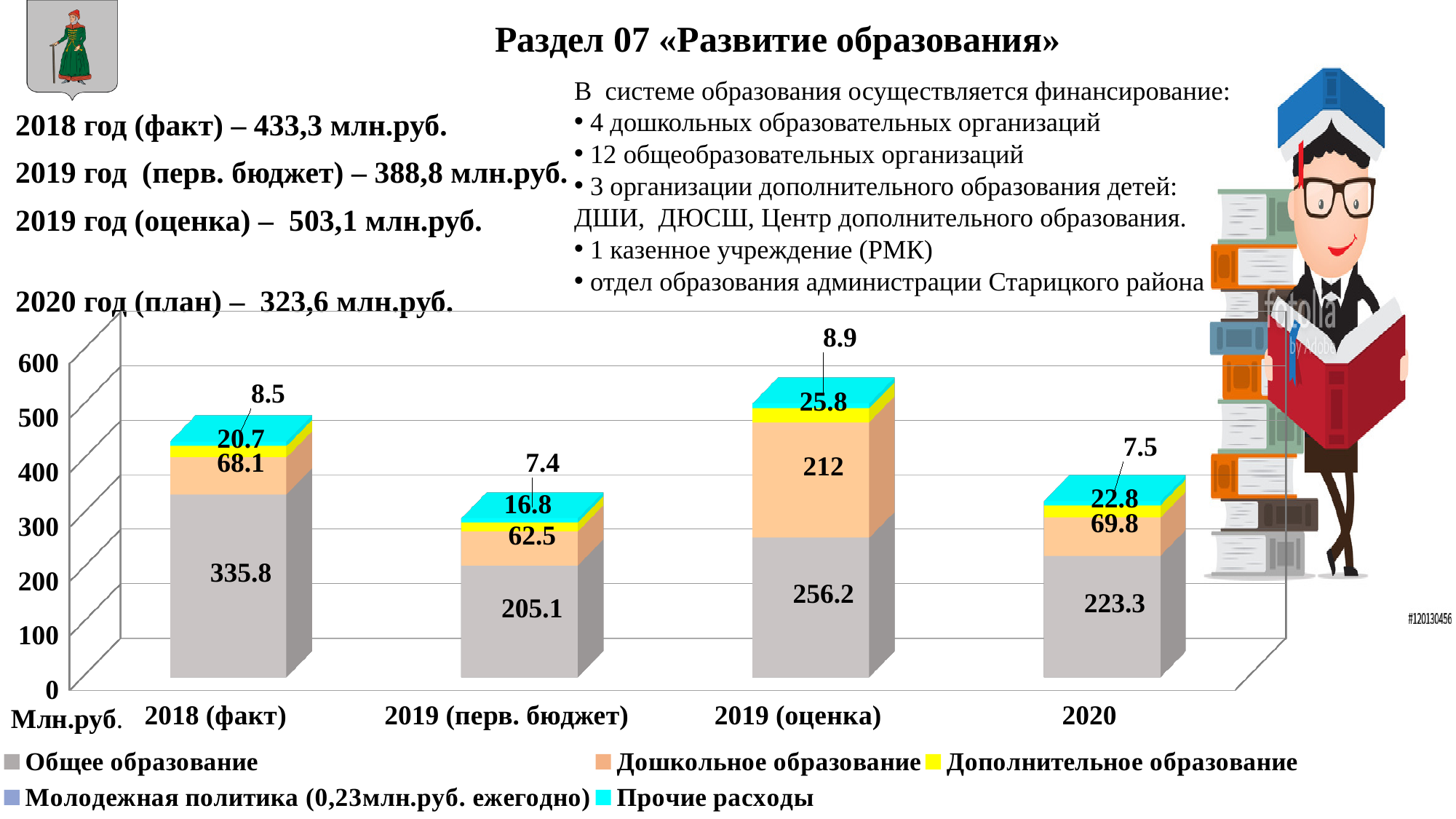
What is the value of Общее образование for 2018 (факт)? 335.8 How many categories are shown on the x axis of the chart? 4 What is the value of Дополнительное образование for 2019 (перв. бюджет)? 16.8 What is the value of Дошкольное образование for 2019 (оценка)? 212 Which is larger, Дошкольное образование for 2020 or for 2018 (факт)? 2020 What is the difference between Общее образование for 2018 (факт) and for 2019 (перв. бюджет)? 130.7 How many series does the chart legend list? 5 What is the difference between Дополнительное образование for 2019 (оценка) and for 2020? 3.0 What is the value of Прочие расходы for 2020? 7.5 Which category has the lowest value for Дошкольное образование? 2019 (перв. бюджет) Which category has the highest value for Общее образование? 2018 (факт) What kind of chart is shown on the slide? Stacked bar chart